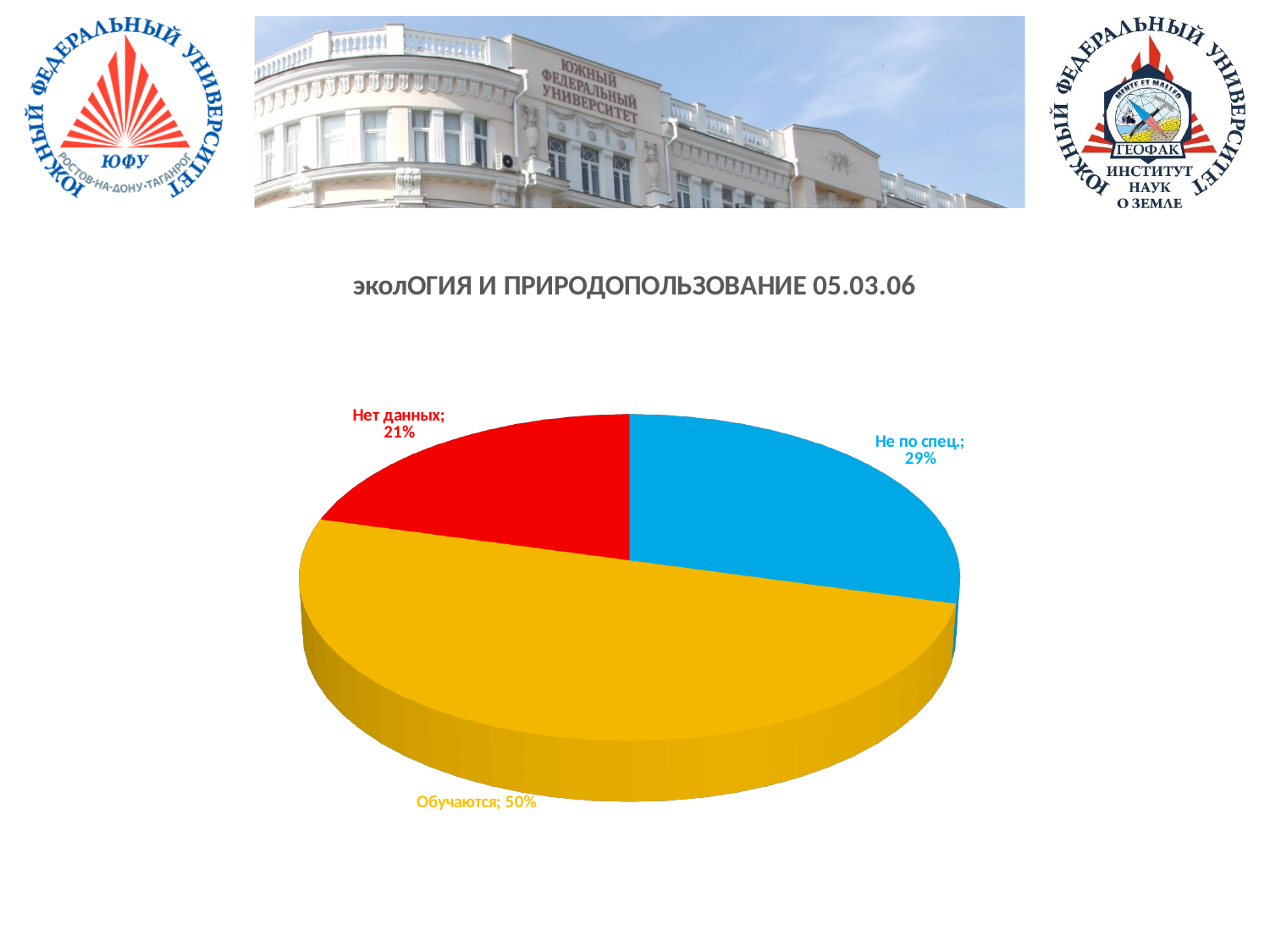
What is the difference in percentage points between "Обучаются" and "Не по спец."? 21% What share of the pie does the "Обучаются" slice represent? 50% How many slices does the pie chart have? 3 Which category has the largest slice of the pie? Обучаются What is the title shown above the chart? эколОГИЯ И ПРИРОДОПОЛЬЗОВАНИЕ 05.03.06 What is the value shown for "Нет данных"? 21% What kind of chart is shown on the slide? pie chart What is the value shown for "Не по спец."? 29% Which is larger, the slice for "Не по спец." or the slice for "Нет данных"? Не по спец. Which category has the smallest slice of the pie? Нет данных What is the difference in percentage points between "Не по спец." and "Нет данных"? 8% What colour is the "Обучаются" slice? yellow